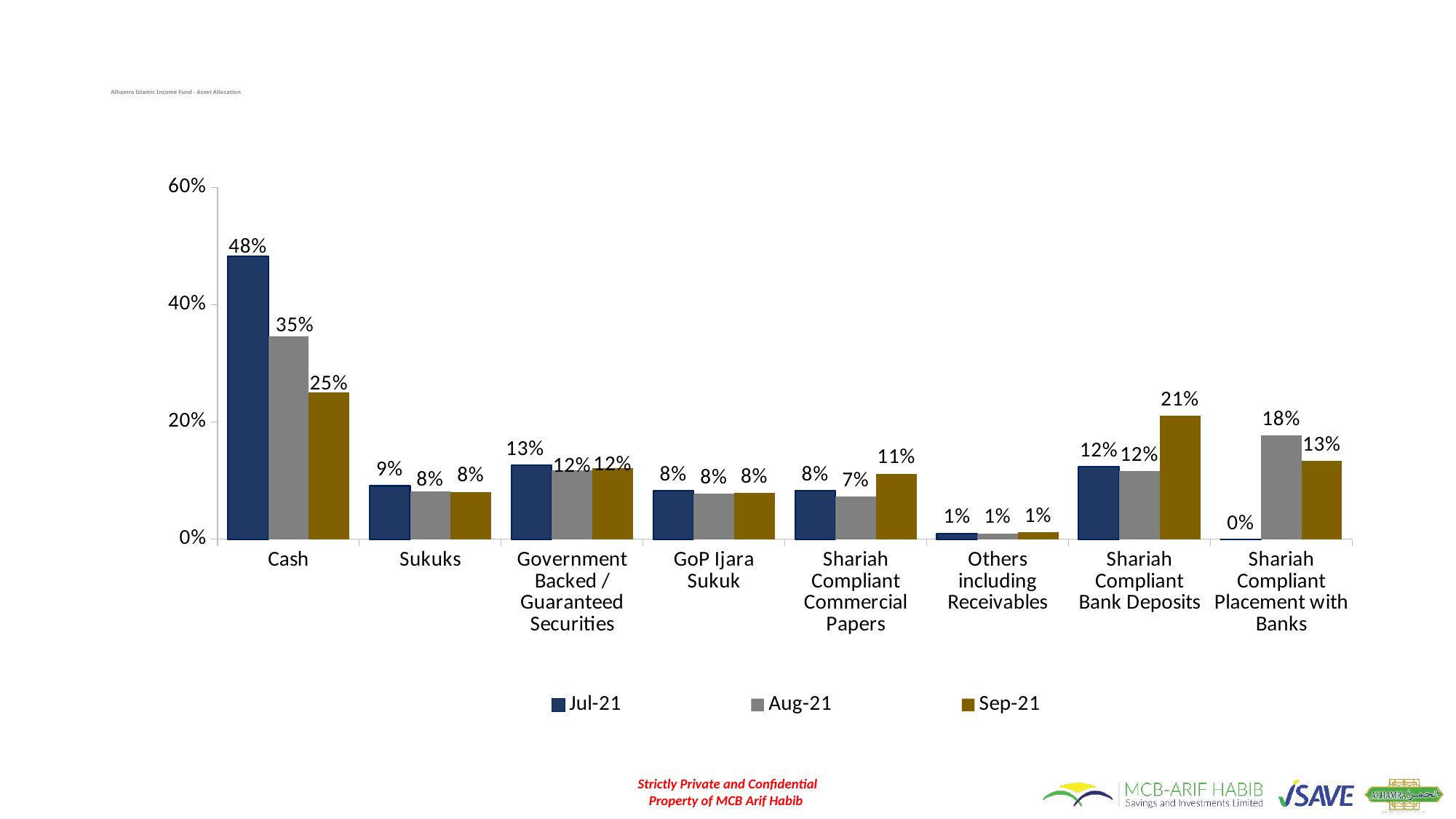
Which is larger for Shariah Compliant Bank Deposits: the Sep-21 value or the Jul-21 value? Sep-21 What is the Aug-21 value for Shariah Compliant Placement with Banks? 18% What is the Sep-21 value for Cash? 25% Which category has the highest Jul-21 value? Cash What is the Jul-21 value for Government Backed / Guaranteed Securities? 13% Which series is shown in dark blue in the legend? Jul-21 What kind of chart is shown on the slide? Bar chart How many categories are shown on the x axis? 8 Which category has the lowest Sep-21 value? Others including Receivables Do the values for Cash rise or fall from Jul-21 to Sep-21? Fall How many series does the legend list? 3 What is the difference between the Jul-21 and Sep-21 values for Cash? 23%